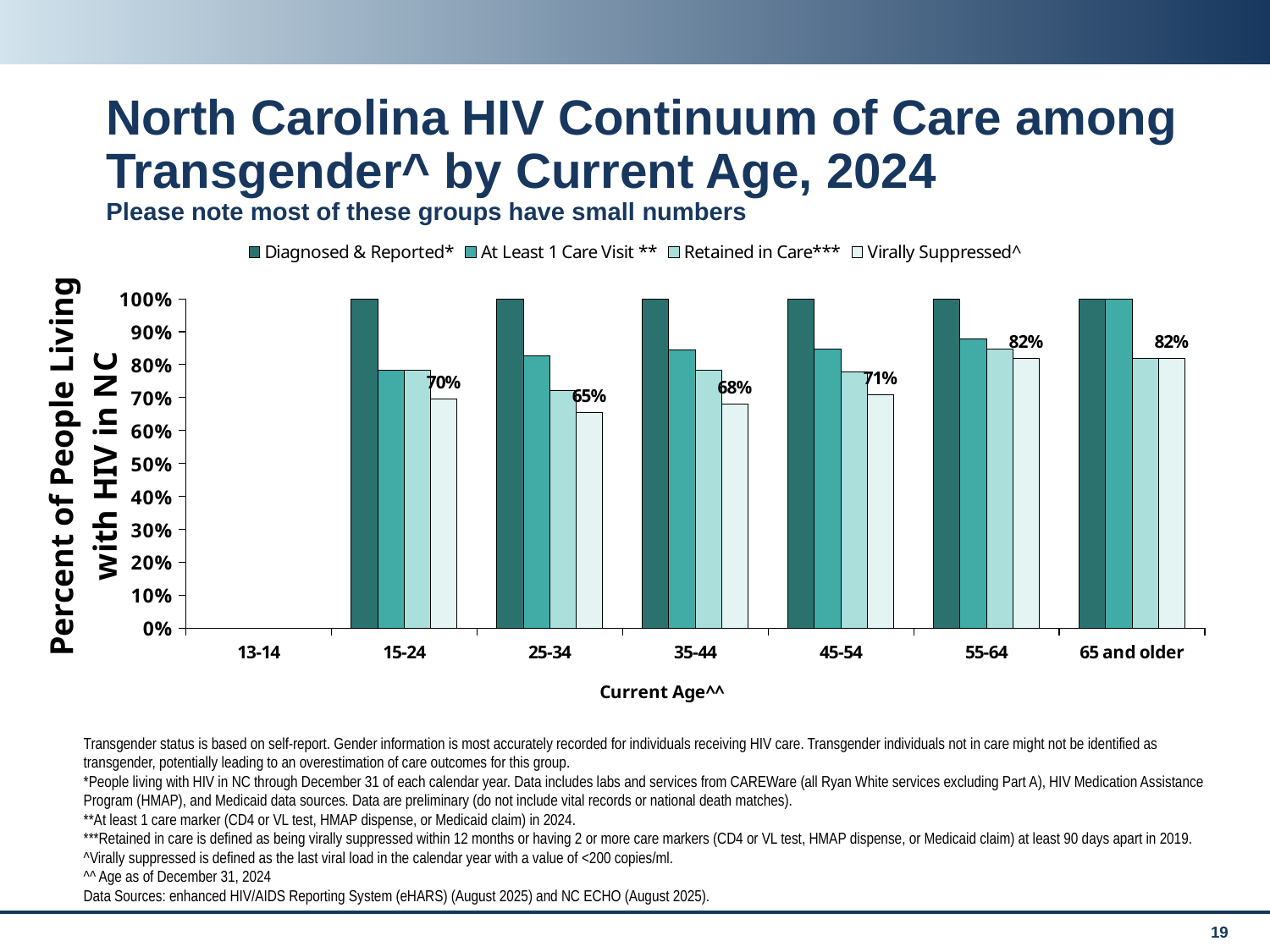
What is the Virally Suppressed^ value for the 25-34 age group? 65% Which age group has a higher Virally Suppressed^ value, 35-44 or 45-54? 45-54 What is the Virally Suppressed^ value for the 55-64 age group? 82% What kind of chart is shown on the slide? Bar chart Which age group has the lowest Virally Suppressed^ value? 25-34 How many series does the legend list? 4 Is the At Least 1 Care Visit ** value for the 15-24 age group greater or less than 70%? greater What is the Virally Suppressed^ value for the 15-24 age group? 70% How many age groups are shown on the x axis? 7 What is the title of the x axis? Current Age^^ What is the difference between the Virally Suppressed^ values for the 55-64 and 25-34 age groups? 17 percentage points Is the Retained in Care*** value for the 25-34 age group greater or less than 80%? less